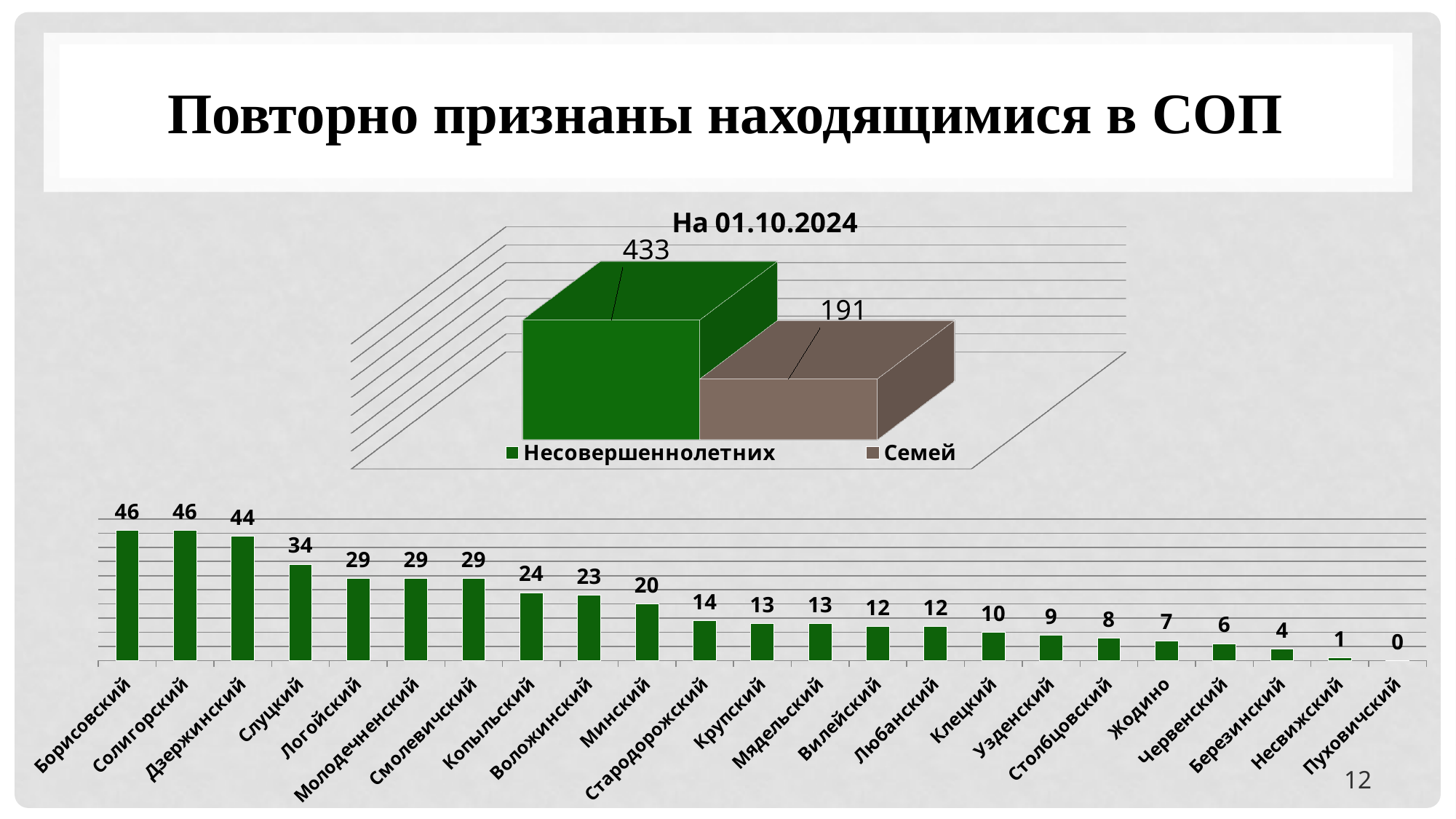
What kind of chart is the bottom chart? Bar chart In the top chart titled 'На 01.10.2024', what is the value for Семей? 191 In the bottom chart, which category has the lowest value? Пуховичский In the bottom chart, what is the value for Минский? 20 In the top chart titled 'На 01.10.2024', what is the value for Несовершеннолетних? 433 In the bottom chart, what is the value for Слуцкий? 34 In the top chart titled 'На 01.10.2024', what is the difference between Несовершеннолетних and Семей? 242 In the top chart titled 'На 01.10.2024', what colour is the bar for Семей? Brown In the top chart titled 'На 01.10.2024', how many series does the legend list? 2 In the bottom chart, what is the difference between Дзержинский and Копыльский? 20 In the bottom chart, which is larger, Логойский or Стародорожский? Логойский In the bottom chart, how many categories are shown on the x axis? 23